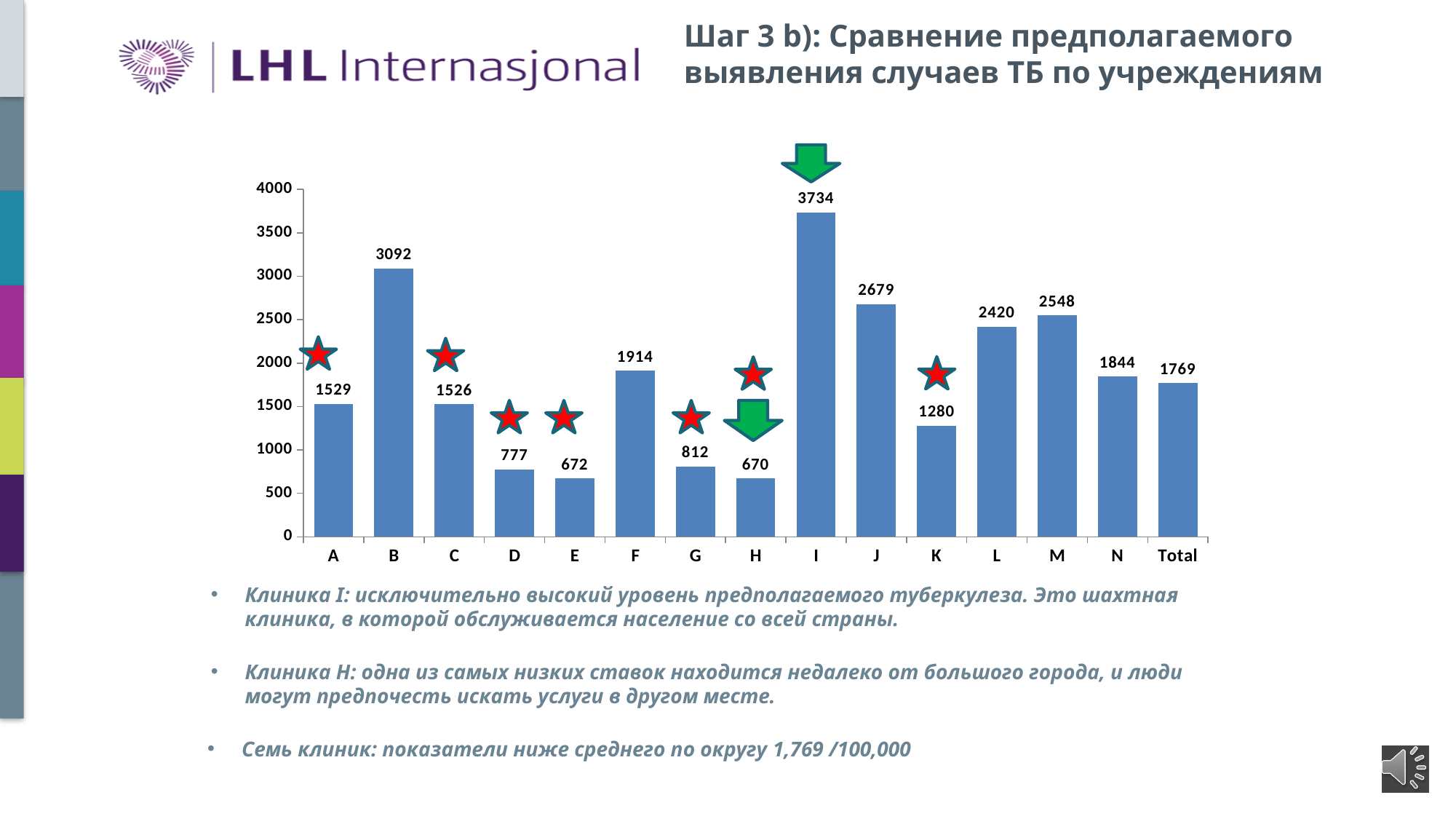
What is the difference between the values for clinic I and clinic B? 642 Which is larger, the value for clinic M or clinic L? M Which is larger, the value for clinic D or clinic G? G What is the value for clinic I? 3734 How many bars are shown on the chart, including Total? 15 Is the value for clinic F greater or less than 1500? greater Which category has the highest bar? I What is the value shown for the Total bar? 1769 What is the difference between the values for clinic J and clinic L? 259 What kind of chart is shown on the slide? Bar chart What is the value for clinic K? 1280 What is the highest value labelled on the vertical axis? 4000